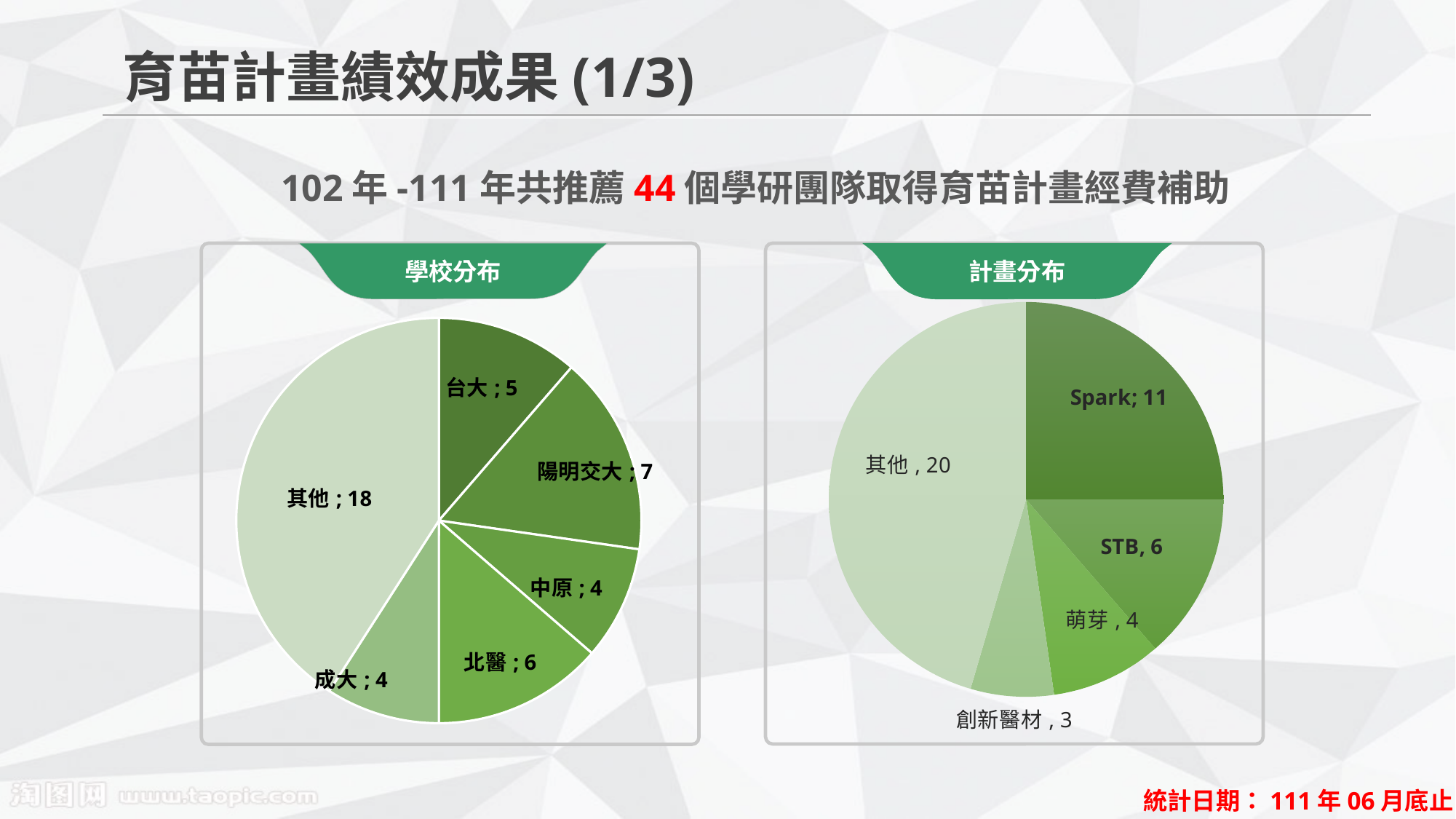
In the 計畫分布 chart, what is the value for 創新醫材? 3 In the 計畫分布 chart, which is larger, STB or 萌芽? STB How many slices does the 計畫分布 chart have? 5 In the 學校分布 chart, which category has the largest slice? 其他 In the 學校分布 chart, what is the value for 陽明交大? 7 In the 計畫分布 chart, what share of the total does Spark represent? 25% In the 學校分布 chart, what is the difference between 其他 and 台大? 13 In the 計畫分布 chart, which category has the smallest slice? 創新醫材 How many slices does the 學校分布 chart have? 6 What type of chart is the 計畫分布 chart? Pie chart In the 計畫分布 chart, what is the value for Spark? 11 In the 學校分布 chart, what is the value for 北醫? 6